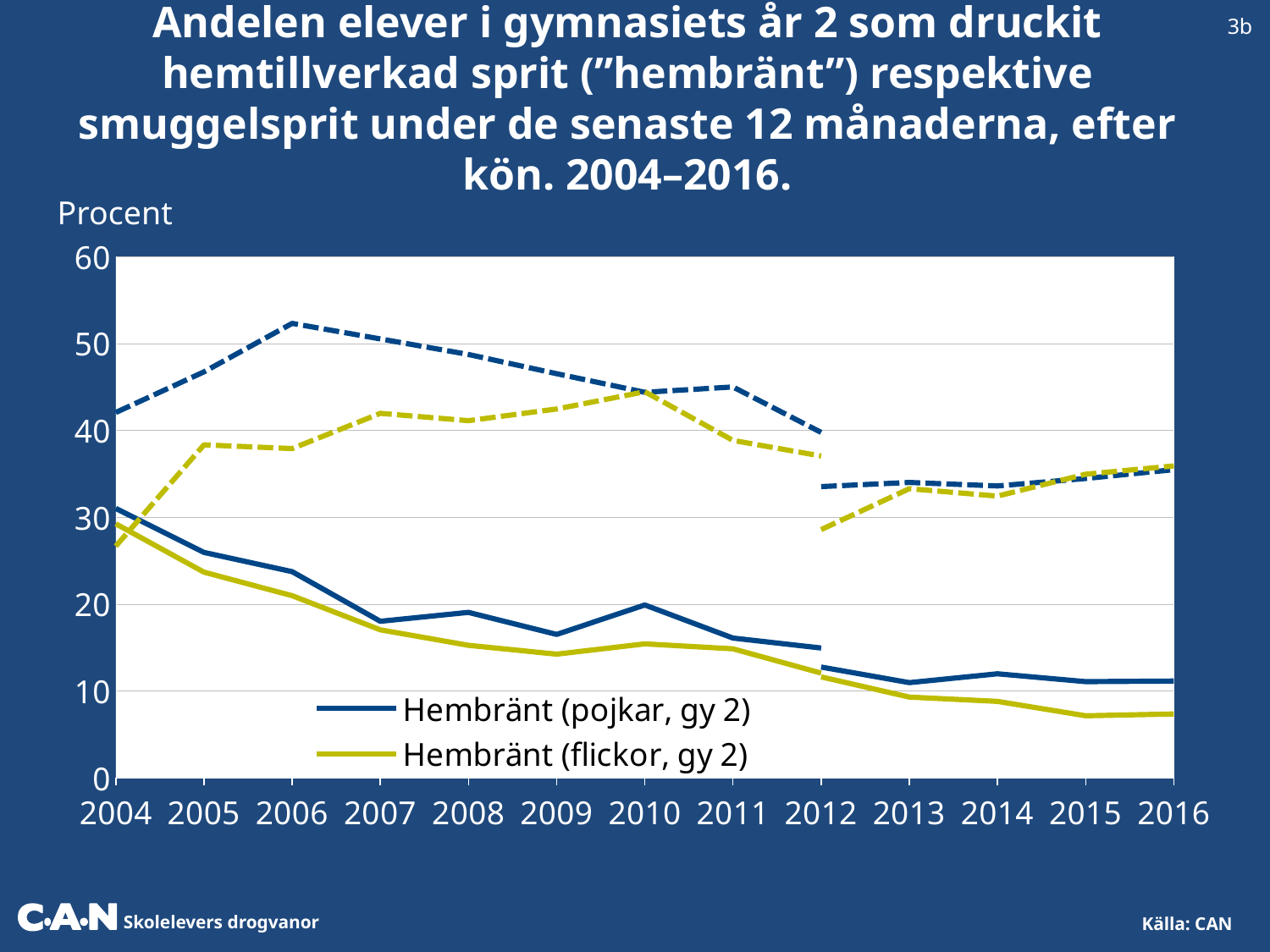
In 2016, which is larger: Hembränt (pojkar, gy 2) or Hembränt (flickor, gy 2)? Hembränt (pojkar, gy 2) What label is shown on the y axis of the chart? Procent Is the value for Hembränt (pojkar, gy 2) in 2006 greater or less than 20? greater What kind of chart is shown on the slide? Line chart How many years are shown along the x axis? 13 Is the value for Hembränt (flickor, gy 2) in 2016 greater or less than 10? less Does the value for Hembränt (pojkar, gy 2) rise or fall from 2004 to 2016? Fall Which year has the highest value for Hembränt (flickor, gy 2)? 2004 Does the value for Hembränt (flickor, gy 2) rise or fall from 2004 to 2016? Fall Is the value for Hembränt (flickor, gy 2) in 2009 greater or less than 20? less Which year has the highest value for Hembränt (pojkar, gy 2)? 2004 How many series does the legend list? 2